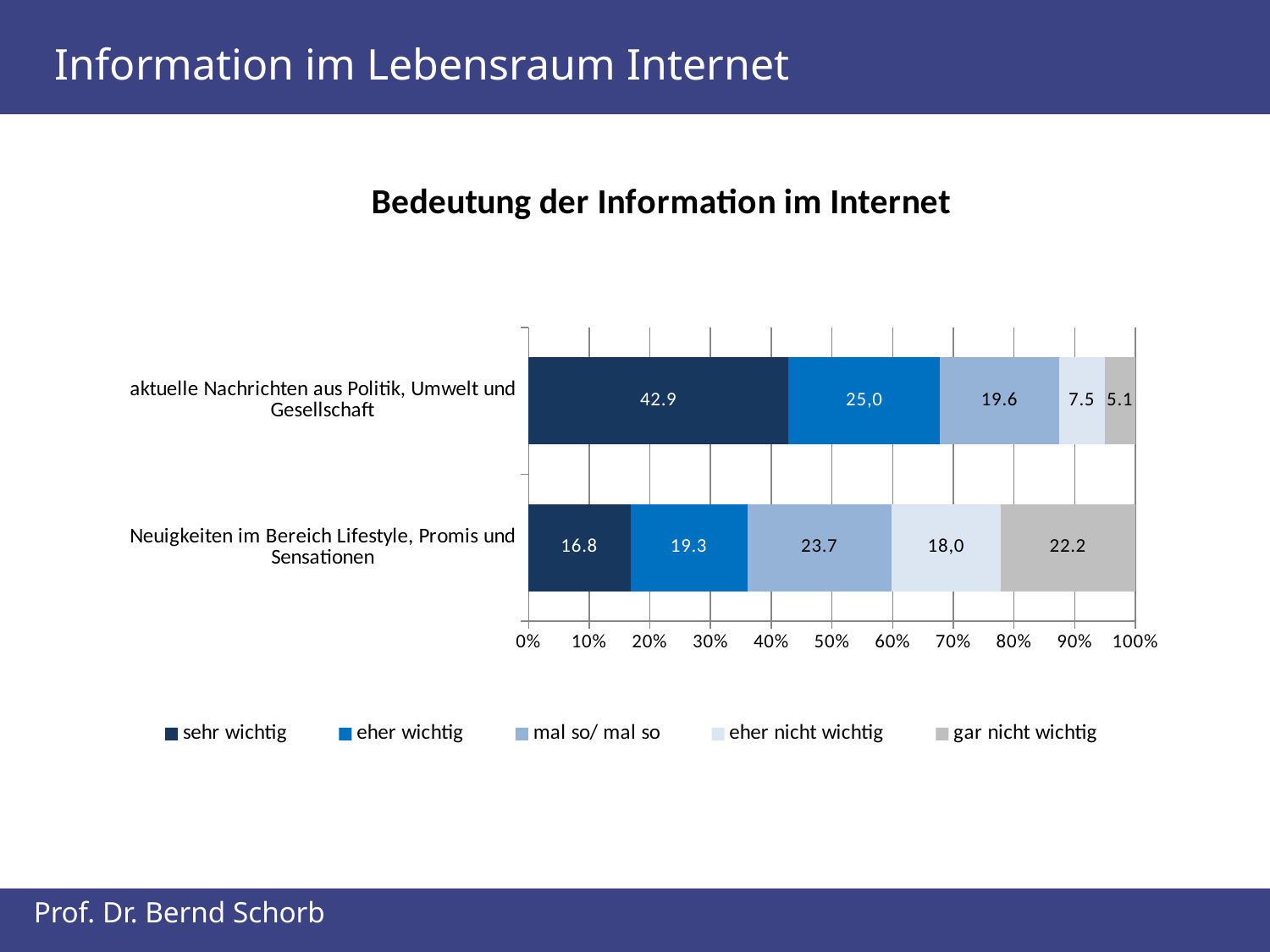
What is the value for 'eher wichtig' for 'aktuelle Nachrichten aus Politik, Umwelt und Gesellschaft'? 25,0 What is the title of the chart? Bedeutung der Information im Internet How many series does the legend list? 5 Which series has the highest value for 'Neuigkeiten im Bereich Lifestyle, Promis und Sensationen'? mal so/ mal so What is the difference between the 'sehr wichtig' values of the two categories? 26.1 What is the value for 'gar nicht wichtig' for 'Neuigkeiten im Bereich Lifestyle, Promis und Sensationen'? 22.2 Which series has the lowest value for 'aktuelle Nachrichten aus Politik, Umwelt und Gesellschaft'? gar nicht wichtig Which category has the higher value for 'sehr wichtig'? aktuelle Nachrichten aus Politik, Umwelt und Gesellschaft What kind of chart is shown on the slide? stacked bar chart What is the value for 'eher nicht wichtig' for 'Neuigkeiten im Bereich Lifestyle, Promis und Sensationen'? 18,0 What is the value for 'sehr wichtig' for 'aktuelle Nachrichten aus Politik, Umwelt und Gesellschaft'? 42.9 How many categories are plotted on the chart? 2